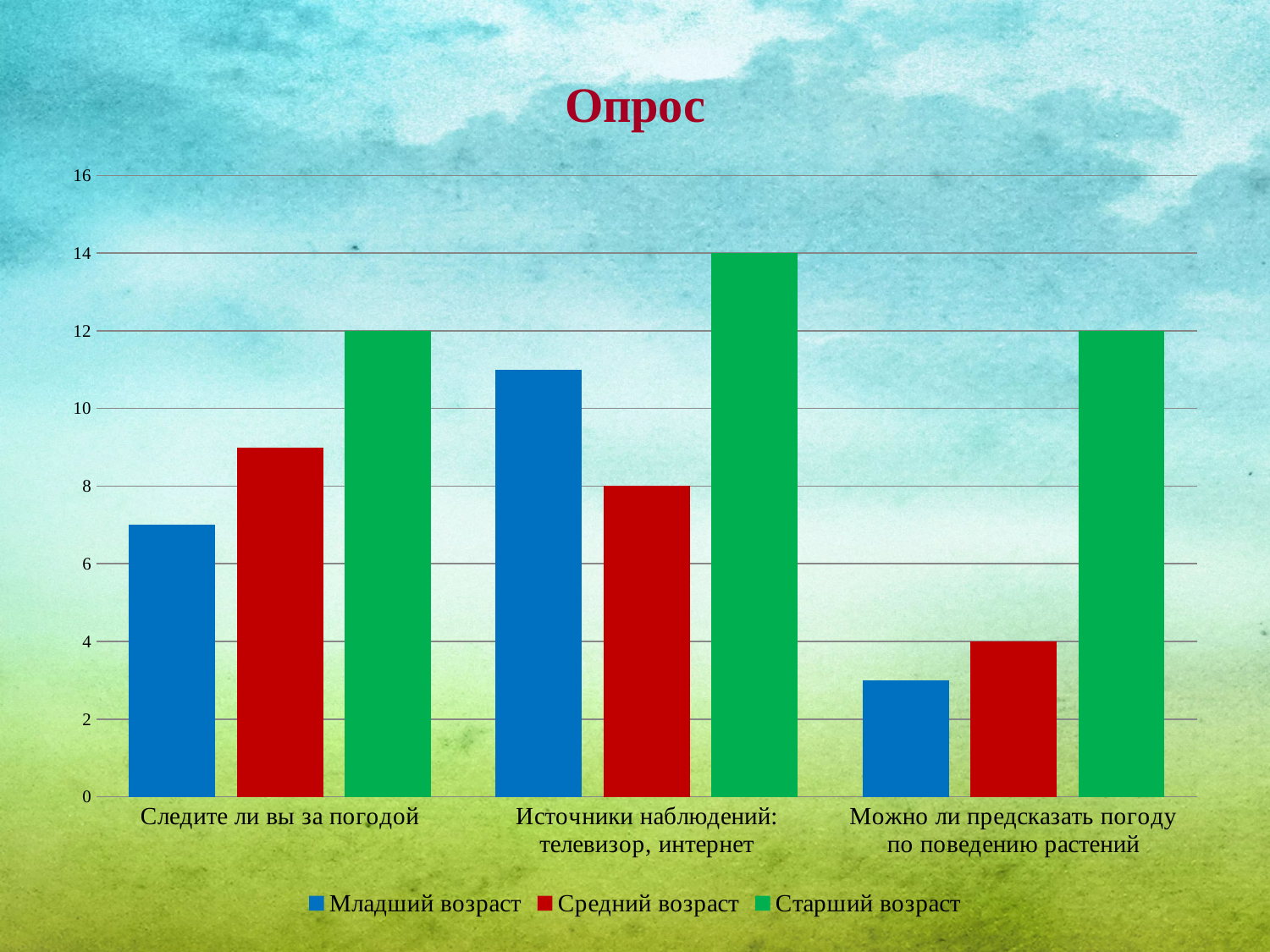
What kind of chart is shown on the slide? bar chart Which series has the lowest bar in the category 'Можно ли предсказать погоду по поведению растений'? Младший возраст Which series has the highest bar in the category 'Источники наблюдений: телевизор, интернет'? Старший возраст Is the value for Младший возраст in the category 'Источники наблюдений: телевизор, интернет' greater or less than 10? greater What is the difference between Старший возраст and Средний возраст in the category 'Источники наблюдений: телевизор, интернет'? 6 How many categories are shown on the x axis? 3 What is the value for Средний возраст in the category 'Источники наблюдений: телевизор, интернет'? 8 Do the values for Средний возраст rise or fall across the categories from left to right? fall What is the value for Старший возраст in the category 'Источники наблюдений: телевизор, интернет'? 14 What is the value for Средний возраст in the category 'Можно ли предсказать погоду по поведению растений'? 4 What is the value for Старший возраст in the category 'Следите ли вы за погодой'? 12 How many series does the legend list? 3